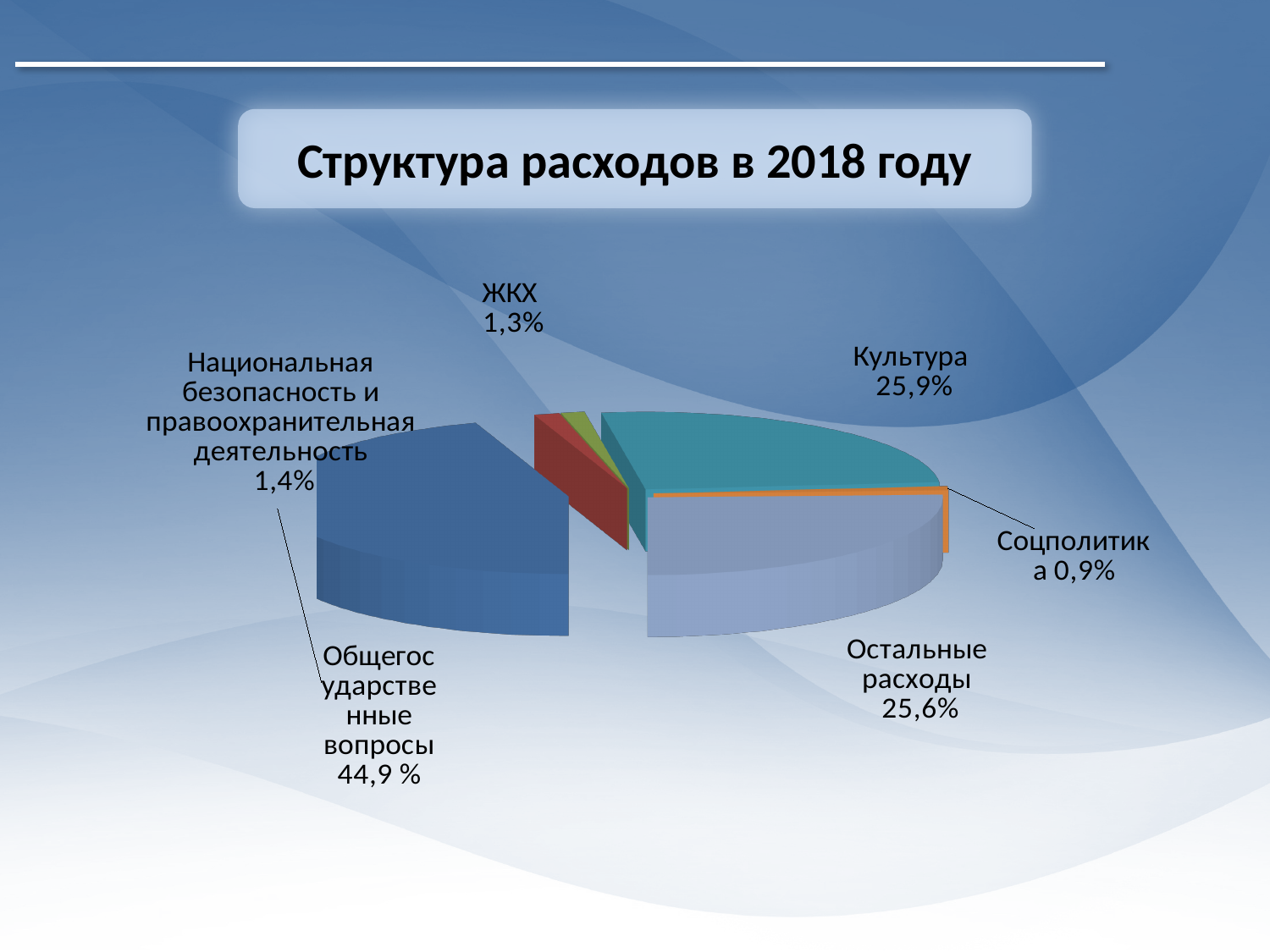
What is the difference in percentage points between Общегосударственные вопросы and Культура? 19 percentage points What share of expenditures is Остальные расходы? 25,6% Which is larger: the share for Культура or the share for Остальные расходы? Культура How many slices does the pie chart have? 6 Which category has the smallest share of expenditures? Соцполитика What share of expenditures is Соцполитика? 0,9% Which category has the largest share of expenditures? Общегосударственные вопросы What is the title of the chart on the slide? Структура расходов в 2018 году What share of expenditures is Общегосударственные вопросы? 44,9 % What share of expenditures is Культура? 25,9% What kind of chart is shown on the slide? pie chart What share of expenditures is ЖКХ? 1,3%